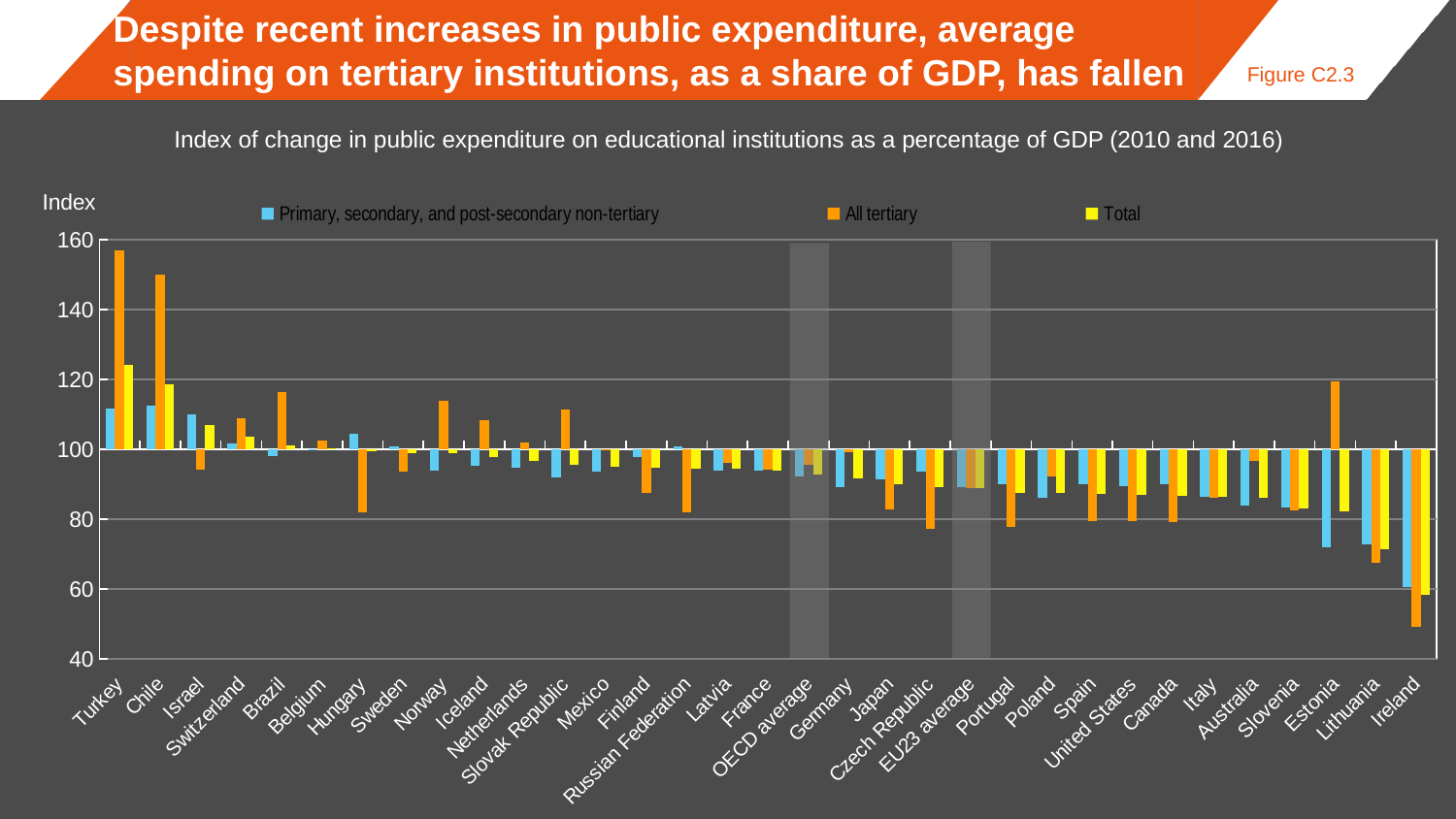
Which country has the highest All tertiary value? Turkey Is the All tertiary value for Ireland greater or less than 60? less Which country has the lowest All tertiary value? Ireland Which has the larger Primary, secondary, and post-secondary non-tertiary value, Estonia or Ireland? Estonia Is the All tertiary value for Estonia greater or less than 100? greater Is the All tertiary value for Turkey greater or less than 140? greater How many series does the legend list? 3 Which colour represents the All tertiary series in the legend? Orange What kind of chart is shown on the slide? Bar chart Do the Total values generally rise or fall from left to right along the x axis? Fall